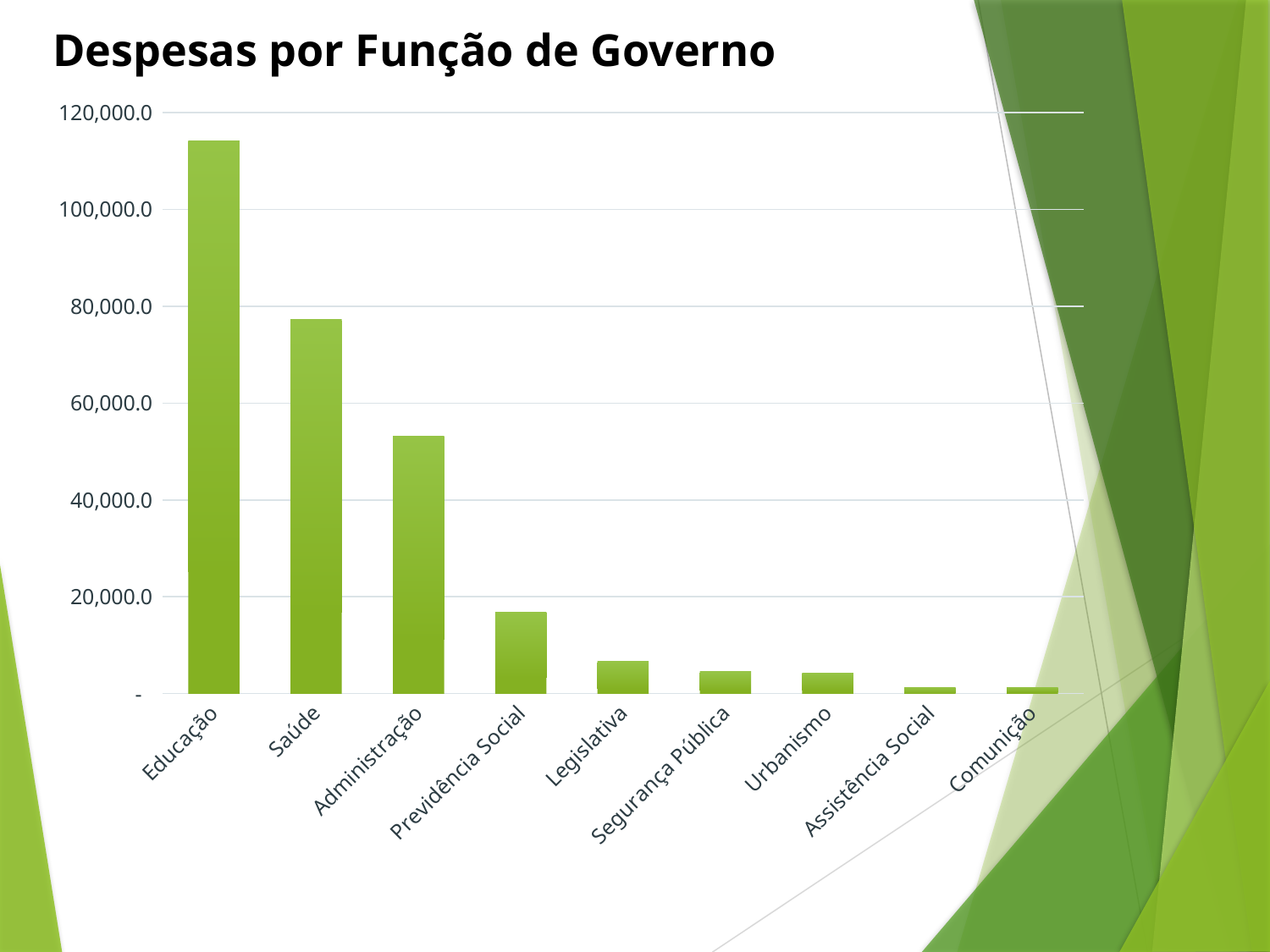
Which has a larger value, Saúde or Administração? Saúde Is the value for Previdência Social greater or less than 20,000.0? less Is the value for Educação greater or less than 100,000.0? greater Which category has the highest value in the chart? Educação Is the value for Legislativa greater or less than 20,000.0? less What kind of chart is shown on the slide? bar chart How many categories are shown on the x axis of the chart? 9 Do the values rise or fall moving from left to right along the x axis? fall What is the title of the chart? Despesas por Função de Governo Which has a larger value, Previdência Social or Legislativa? Previdência Social